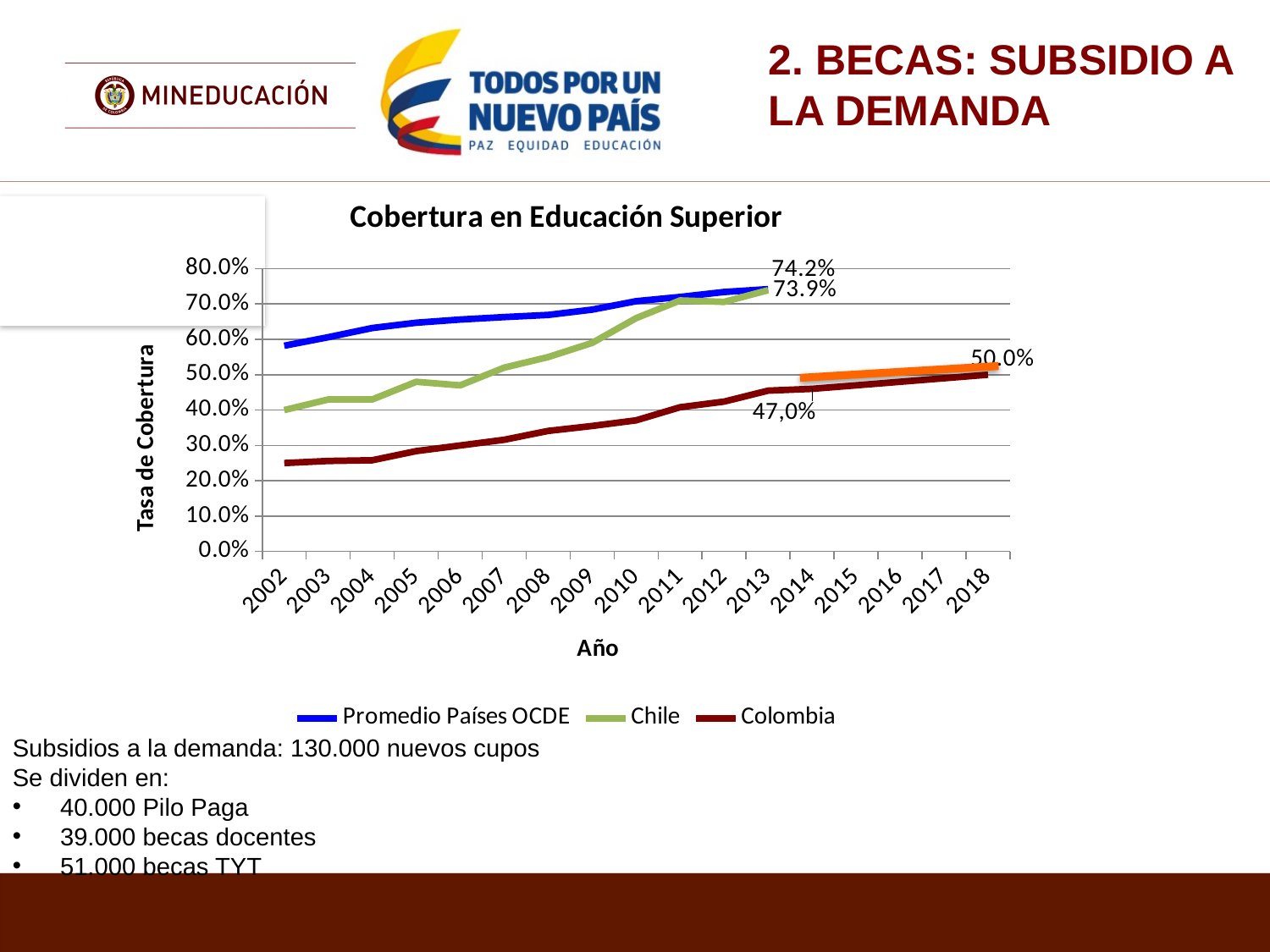
Is the value for Promedio Países OCDE in 2002 greater or less than 50.0%? greater What kind of chart is shown on the slide? Line chart How many series does the legend list? 3 Which series are listed in the chart legend? Promedio Países OCDE, Chile, Colombia What is the labelled value for Colombia in 2018? 50.0% What is the labelled value for Colombia in 2014? 47,0% How many years are shown on the x axis? 17 Does the Colombia line rise or fall from 2002 to 2018? Rise By how many percentage points does the Colombia value rise from the 2014 label (47,0%) to the 2018 label (50.0%)? 3 percentage points Which series has the lowest value in 2010? Colombia Is the value for Colombia in 2002 greater or less than 30.0%? less What is the title of the chart? Cobertura en Educación Superior